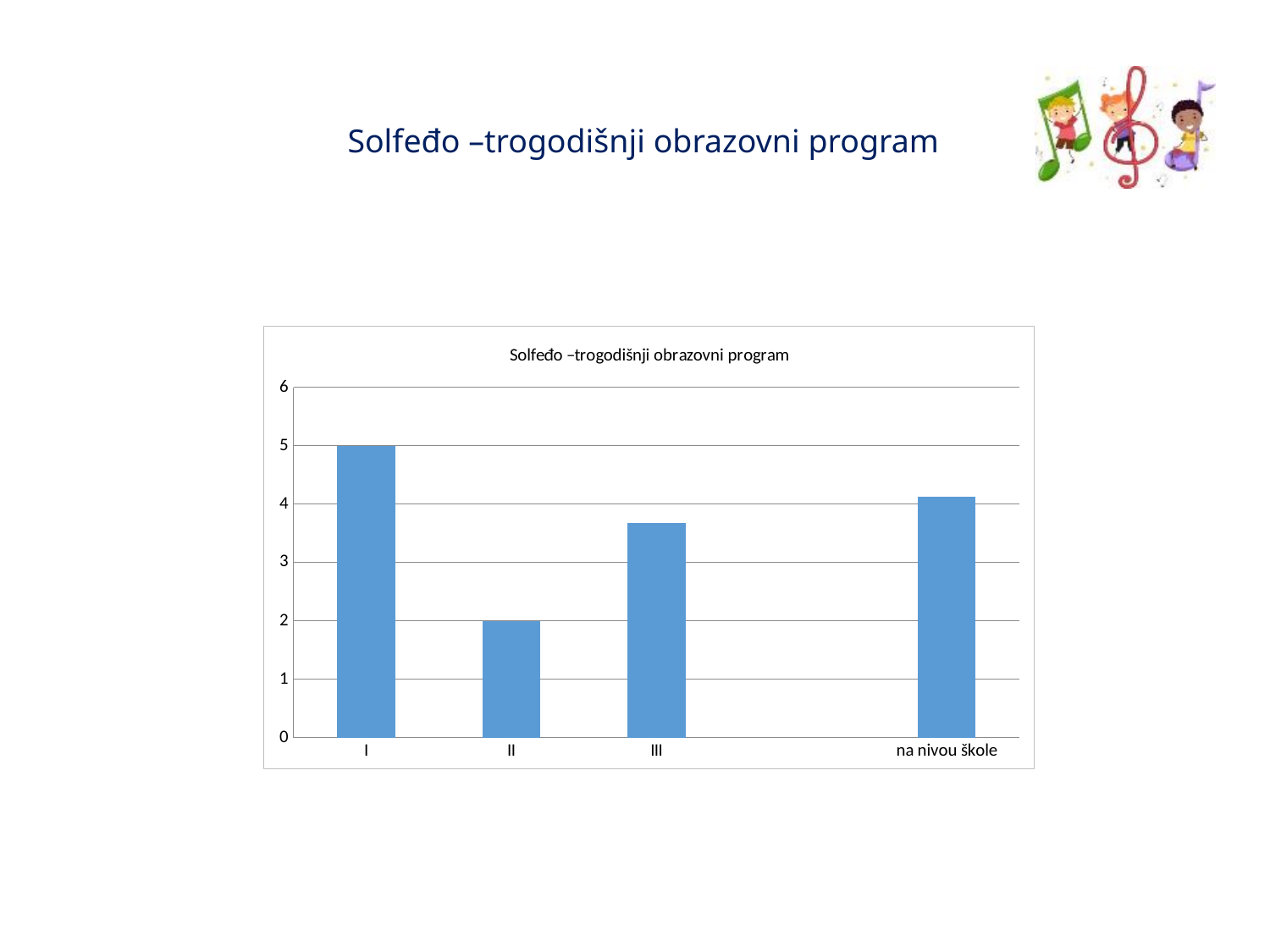
What is the value for category II? 2 Which category has the lowest value? II Which category has the highest value? I Which is larger, the value for II or the value for na nivou škole? na nivou škole Is the value for na nivou škole greater or less than 4? greater Which is larger, the value for I or the value for III? I Is the value for III greater or less than 4? less What is the value for category I? 5 What is the difference between the values for I and II? 3 What kind of chart is shown on the slide? bar chart How many categories are shown on the x axis? 4 What is the title of the chart? Solfeđo –trogodišnji obrazovni program